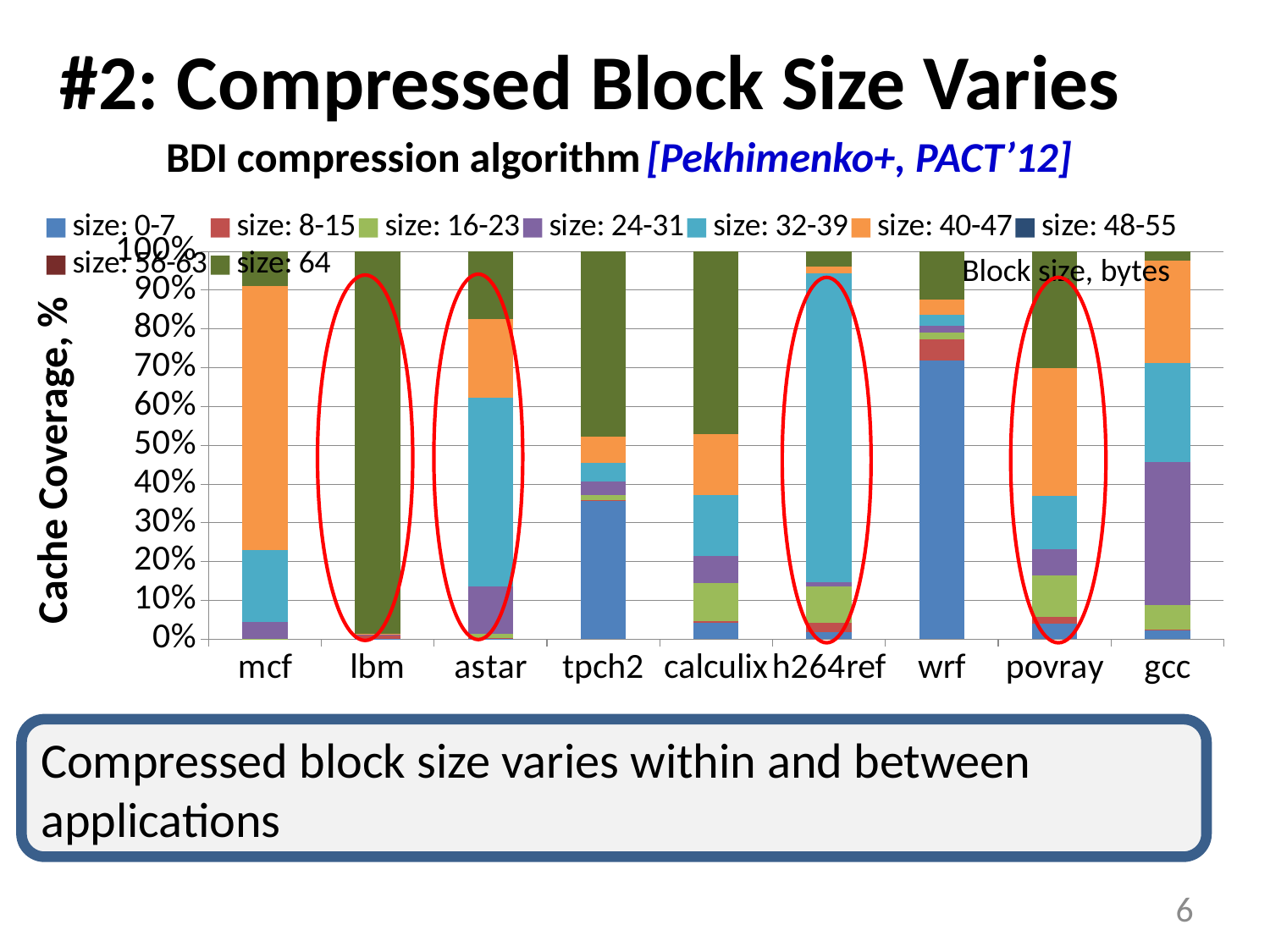
How many applications (categories) are shown along the x axis of the chart? 9 Is the 'size: 0-7' share for tpch2 greater or less than 20%? greater What is the total height of the stacked bar for mcf? 100% Which application has the largest share for the series 'size: 32-39'? h264ref Is the 'size: 64' share for lbm greater or less than 90%? greater Is the 'size: 0-7' share for wrf greater or less than 60%? greater Which application has the largest share for the series 'size: 64'? lbm How many series does the chart's legend list? 9 Which is larger: the 'size: 0-7' share for wrf or for tpch2? wrf What is the title of the y axis of the chart? Cache Coverage, % What kind of chart is shown on the slide? stacked bar chart Which application has the largest share for the series 'size: 0-7'? wrf